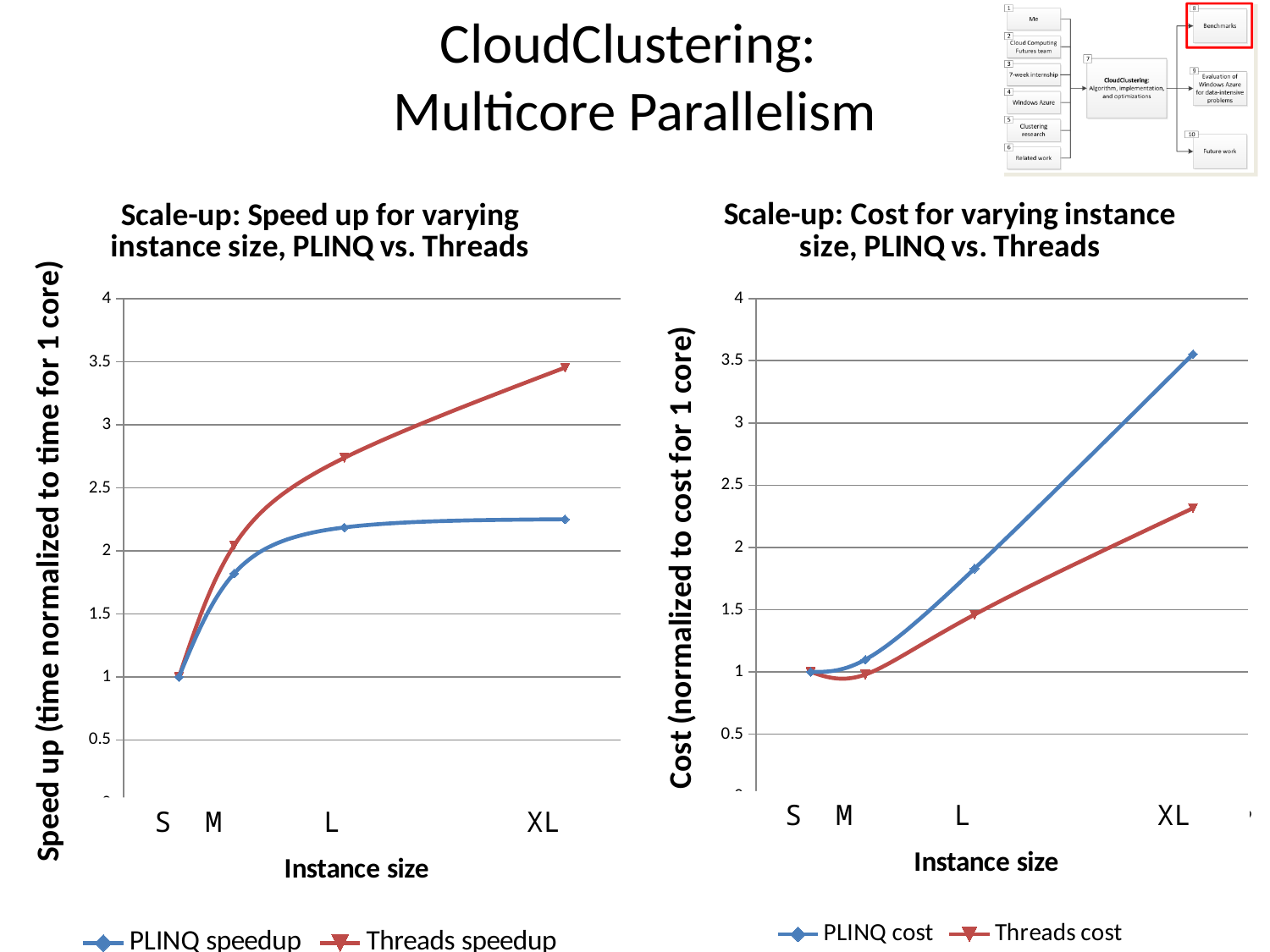
In the 'Scale-up: Cost for varying instance size' chart, is the Threads cost at XL greater or less than 2.5? less How many series does the legend of the 'Scale-up: Speed up for varying instance size' chart list? 2 In the 'Scale-up: Speed up for varying instance size' chart, is the Threads speedup at XL greater or less than 3? greater In the 'Scale-up: Speed up for varying instance size' chart, which series has the higher value at XL, PLINQ speedup or Threads speedup? Threads speedup How many instance sizes are plotted along the x axis of the 'Scale-up: Speed up for varying instance size' chart? 4 What kind of chart is the 'Scale-up: Speed up for varying instance size, PLINQ vs. Threads' chart? line chart In the 'Scale-up: Cost for varying instance size' chart, is the PLINQ cost at XL greater or less than 3? greater What are the two legend entries of the 'Scale-up: Cost for varying instance size' chart? PLINQ cost and Threads cost In the 'Scale-up: Speed up for varying instance size' chart, does the Threads speedup rise or fall from S to XL? rise In the 'Scale-up: Cost for varying instance size, PLINQ vs. Threads' chart, which series has the higher value at XL, PLINQ cost or Threads cost? PLINQ cost In the 'Scale-up: Speed up for varying instance size' chart, what is the PLINQ speedup at instance size S? 1